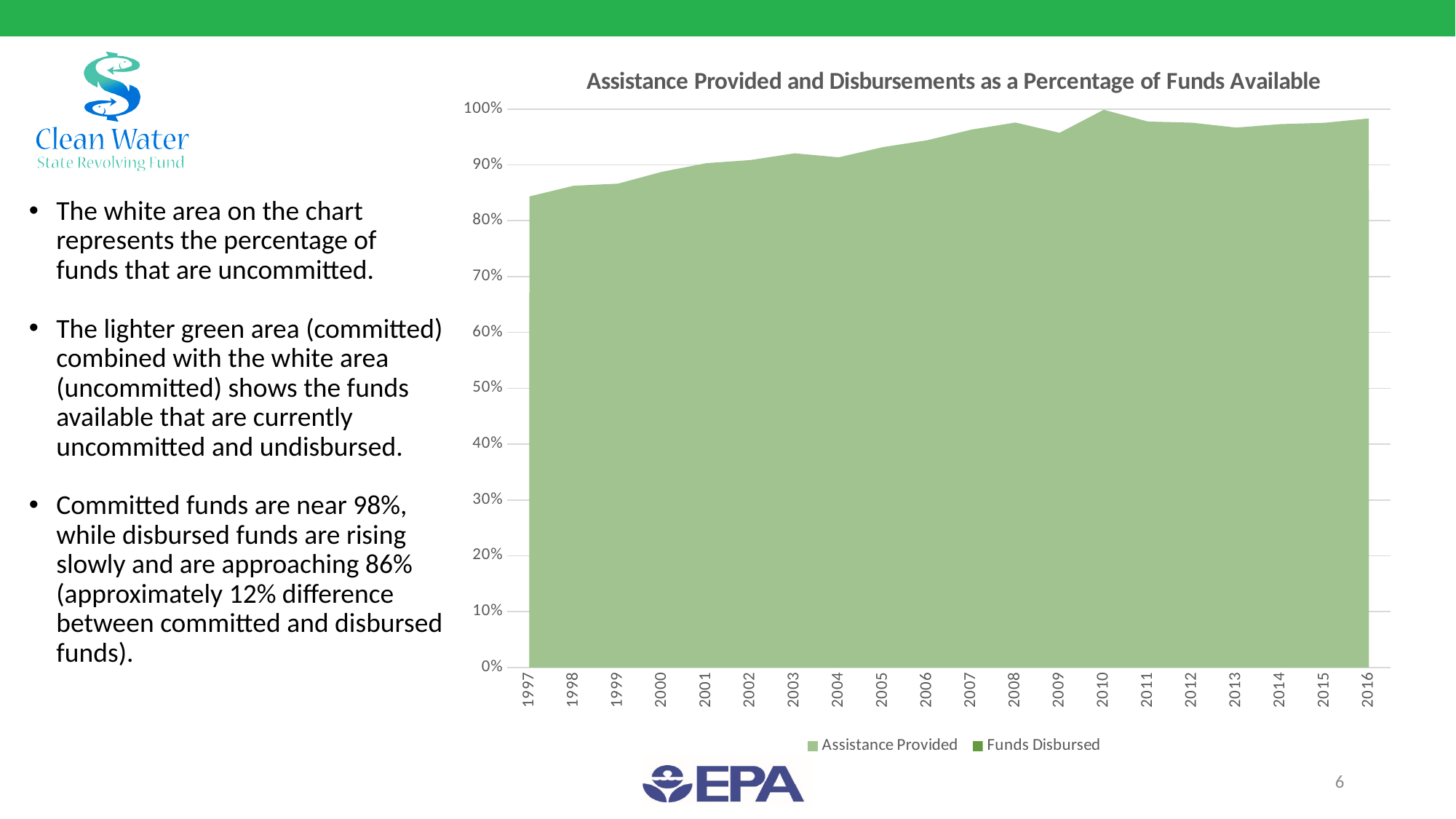
How many years are shown along the x axis of the chart? 20 How many series does the chart legend list? 2 Which year has the highest Assistance Provided value? 2010 Which year has a higher Assistance Provided value, 1997 or 2016? 2016 Does the Assistance Provided value generally rise or fall from 1997 to 2016? Rise Is the Assistance Provided value for 2016 greater or less than 90%? greater Is the Assistance Provided value for 1997 greater or less than 80%? greater Which year has the lowest Assistance Provided value? 1997 Which year has a higher Assistance Provided value, 2000 or 2010? 2010 What is the title of the chart? Assistance Provided and Disbursements as a Percentage of Funds Available Is the Assistance Provided value for 1997 greater or less than 90%? less What kind of chart is shown on the slide? Area chart